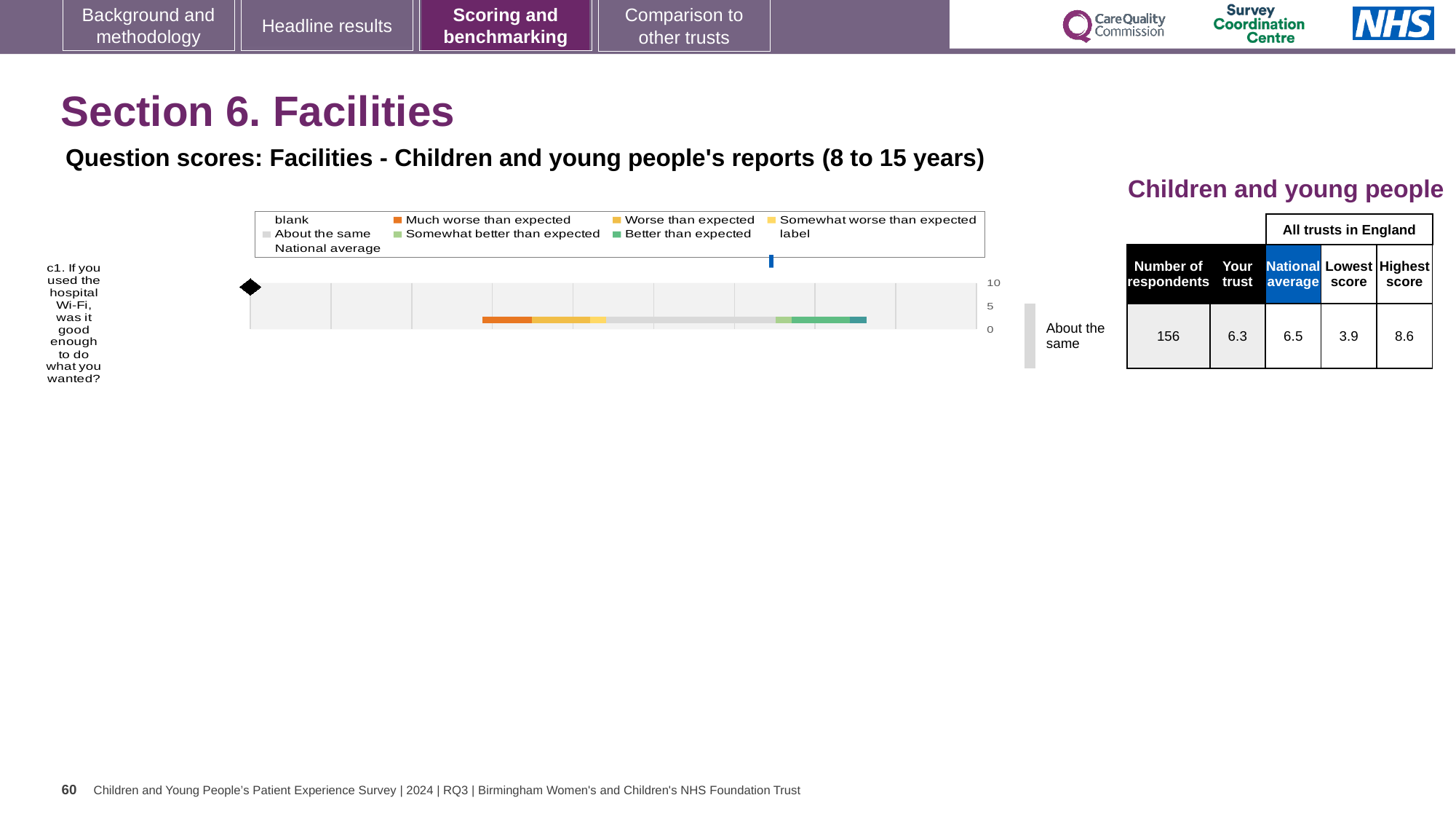
What kind of chart is shown on the slide? bar chart What is the difference between the highest score and the lowest score for question c1? 4.7 What benchmark category is shown next to the chart for question c1? About the same According to the table beside the chart, what is the lowest score among all trusts in England for question c1? 3.9 Which survey question is plotted in the chart? c1. If you used the hospital Wi-Fi, was it good enough to do what you wanted? According to the table beside the chart, what is the highest score among all trusts in England for question c1? 8.6 According to the table beside the chart, what is the number of respondents for question c1? 156 What is the difference between the national average and the 'Your trust' score for question c1? 0.2 How many survey questions are plotted in the chart? 1 According to the table beside the chart, what is the national average score for question c1? 6.5 According to the table beside the chart, what is the 'Your trust' score for question c1? 6.3 Which is larger for question c1: the 'Your trust' score or the national average? National average